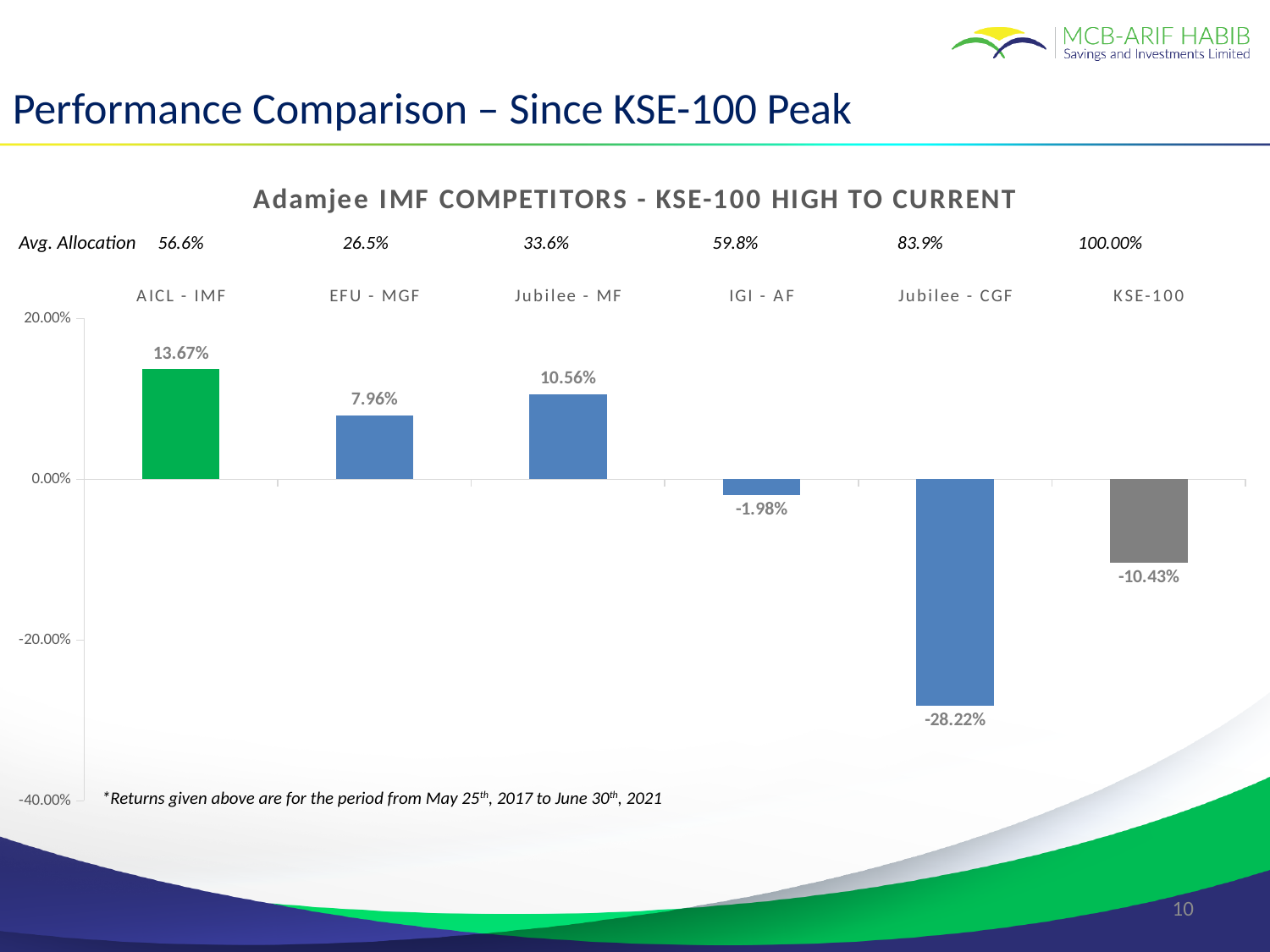
What is the difference between the returns of AICL - IMF and Jubilee - MF? 3.11% Which has a higher return, EFU - MGF or Jubilee - MF? Jubilee - MF What is the Avg. Allocation shown above the Jubilee - CGF bar? 83.9% Which category has the highest return? AICL - IMF Which category has the lowest return? Jubilee - CGF What kind of chart is shown on the slide? Bar chart What is the return shown for AICL - IMF? 13.67% What is the return shown for KSE-100? -10.43% How many categories are shown in the chart? 6 What is the title of the chart? Adamjee IMF COMPETITORS - KSE-100 HIGH TO CURRENT What is the return shown for Jubilee - CGF? -28.22% What is the return shown for IGI - AF? -1.98%